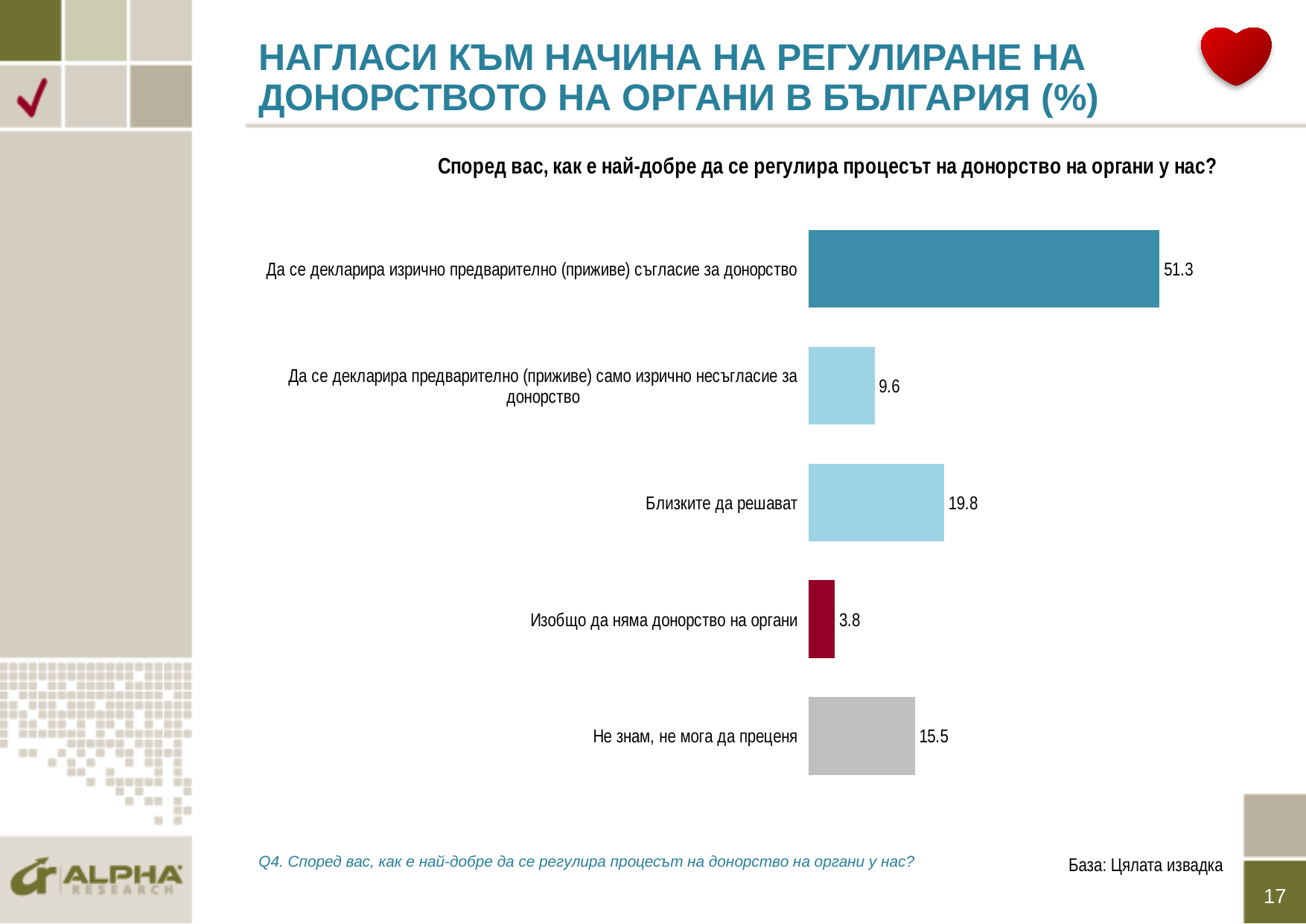
What is the value for "Не знам, не мога да преценя"? 15.5 What is the value for "Да се декларира изрично предварително (приживе) съгласие за донорство"? 51.3 Which category has the highest value? Да се декларира изрично предварително (приживе) съгласие за донорство What is the difference between the values for "Близките да решават" and "Не знам, не мога да преценя"? 4.3 Which category has the lowest value? Изобщо да няма донорство на органи What is the value for "Изобщо да няма донорство на органи"? 3.8 What is the difference between the values for "Да се декларира изрично предварително (приживе) съгласие за донорство" and "Да се декларира предварително (приживе) само изрично несъгласие за донорство"? 41.7 What kind of chart is shown on the slide? Bar chart What colour is the bar for "Изобщо да няма донорство на органи"? Dark red How many categories are shown in the chart? 5 What is the value for "Близките да решават"? 19.8 Which is larger: the value for "Да се декларира предварително (приживе) само изрично несъгласие за донорство" or the value for "Не знам, не мога да преценя"? Не знам, не мога да преценя